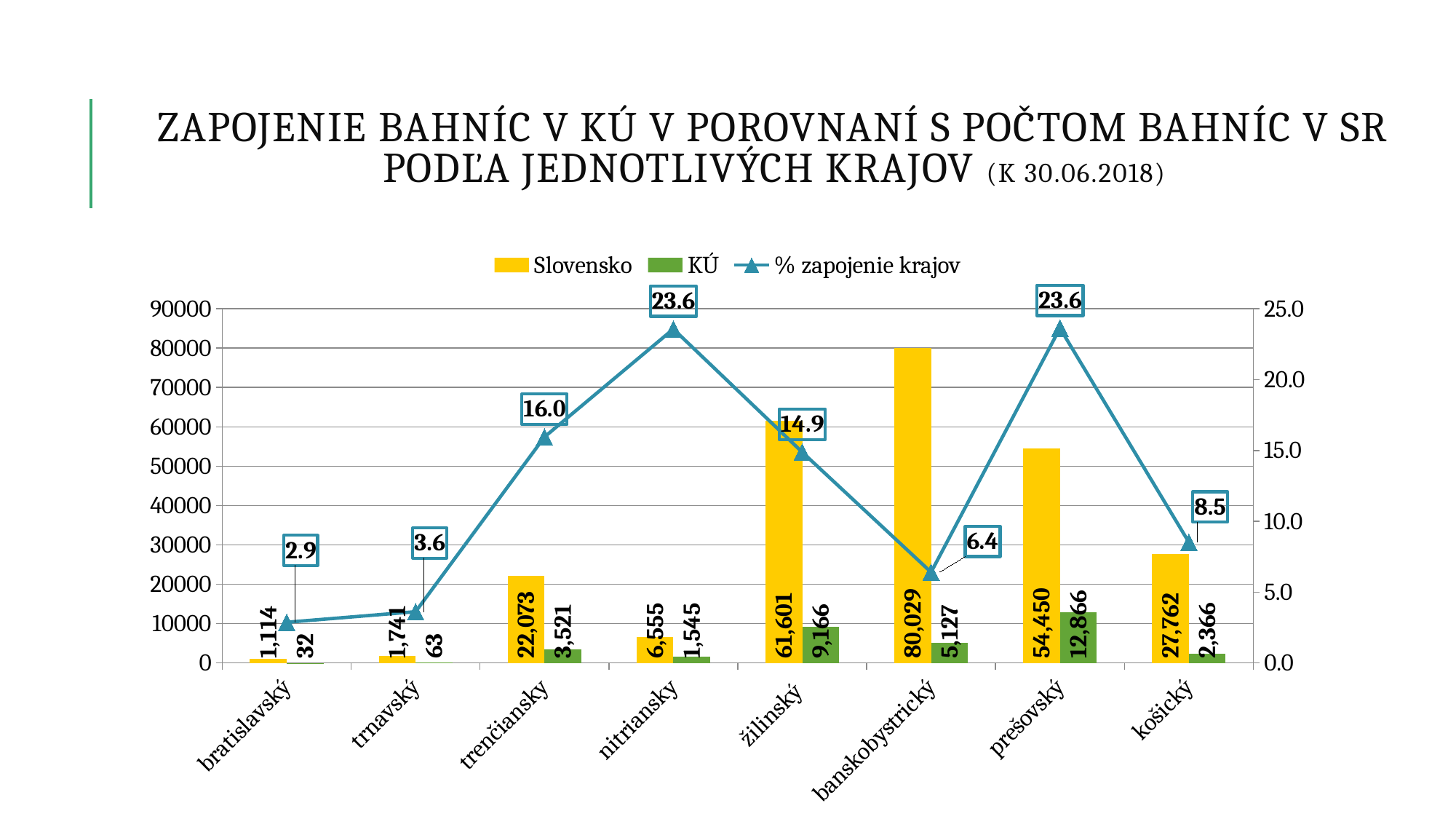
Which region has the lowest % zapojenie krajov value? bratislavský Which is larger, the KÚ value for trenčiansky or for nitriansky? trenčiansky What is the % zapojenie krajov value for košický? 8.5 Which region has the highest Slovensko value? banskobystrický Which region has the lowest KÚ value? bratislavský How many series does the legend list? 3 What is the difference between the KÚ values for prešovský and žilinský? 3,700 What colour are the Slovensko bars? Yellow What is the difference between the Slovensko values for banskobystrický and žilinský? 18,428 What is the Slovensko value for banskobystrický? 80,029 How many regions are shown on the x axis? 8 What is the KÚ value for prešovský? 12,866